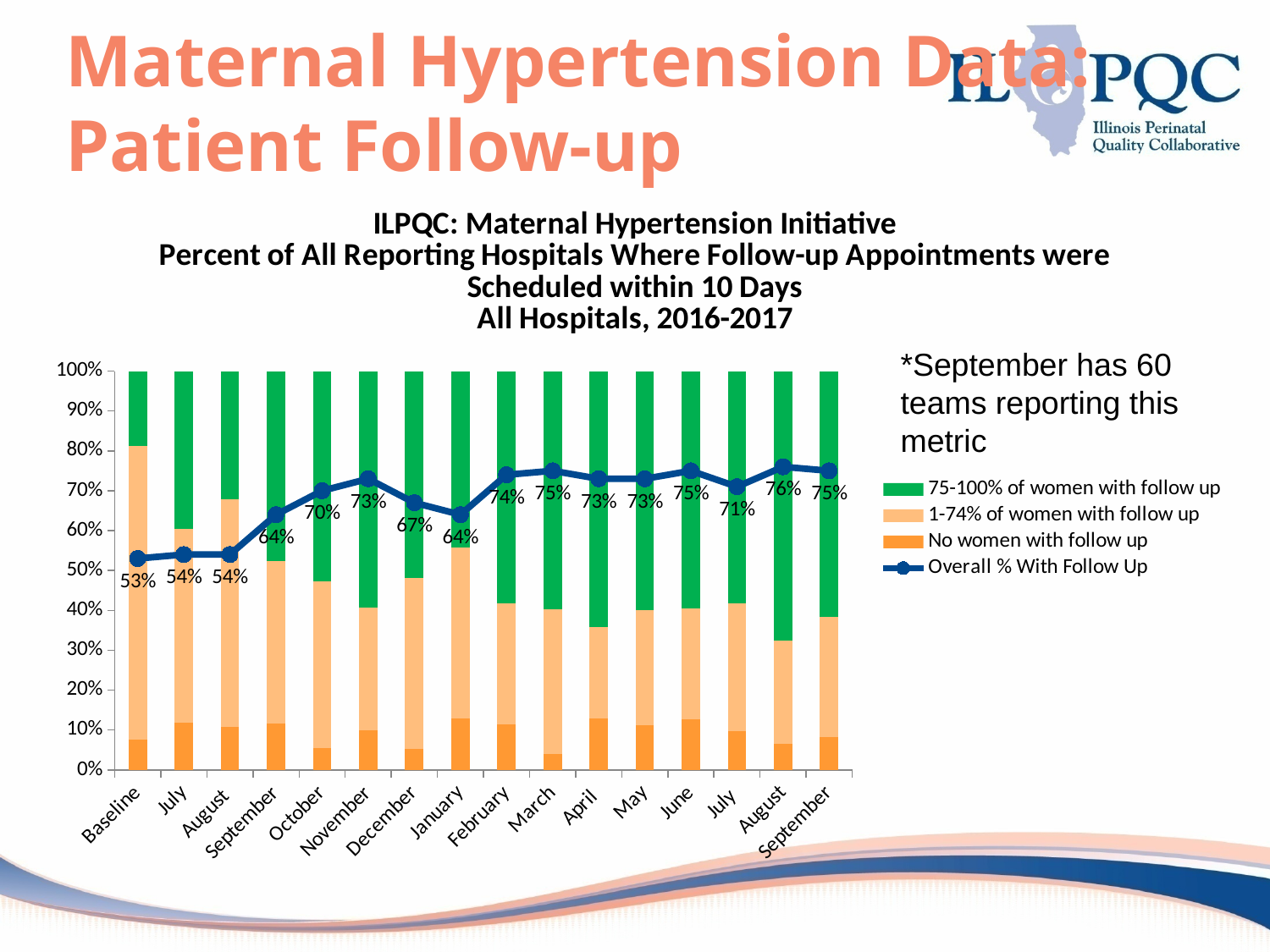
How many entries does the legend list? 4 What kind of chart is shown on the slide? Stacked bar chart with a line overlay Which has a higher Overall % With Follow Up value, October or December? October Does the Overall % With Follow Up line generally rise or fall from Baseline to the final September? Rise What is the Overall % With Follow Up value for Baseline? 53% What is the difference between the Overall % With Follow Up values for March and Baseline? 22 percentage points What is the Overall % With Follow Up value for November? 73% How many categories are shown along the x axis? 16 Is the 'No women with follow up' segment for Baseline greater or less than 10%? less What is the Overall % With Follow Up value for January? 64% Which category has the lowest Overall % With Follow Up value? Baseline What is the highest value shown on the Overall % With Follow Up line? 76%